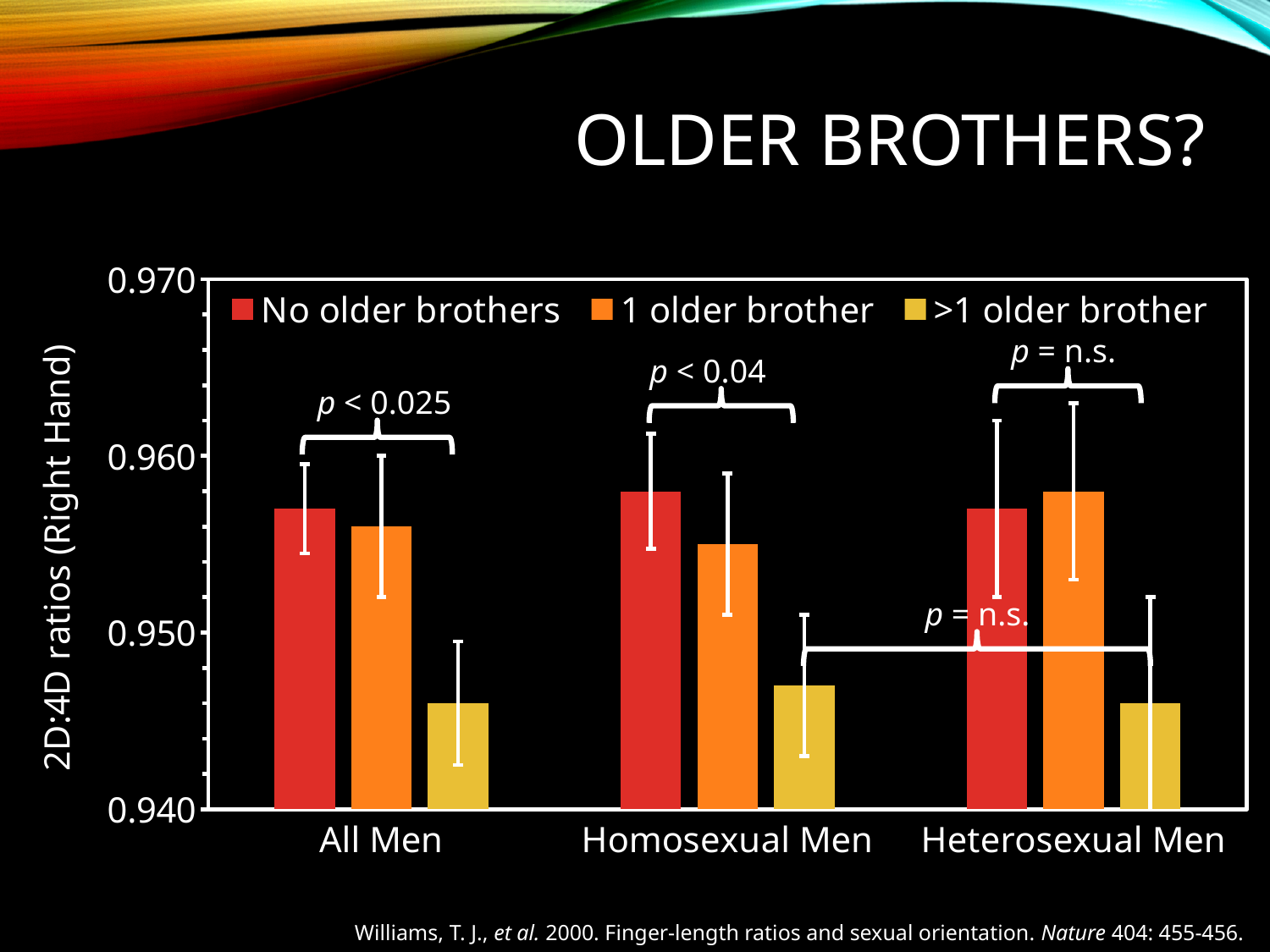
What is the label of the y axis? 2D:4D ratios (Right Hand) Is the value for 1 older brother in the Homosexual Men group greater or less than 0.950? greater How many categories are shown on the x axis? 3 Within the All Men group, which series has the lowest value? >1 older brother Is the value for >1 older brother in the Heterosexual Men group greater or less than 0.950? less Is the value for >1 older brother in the All Men group greater or less than 0.950? less In the All Men group, which is larger: No older brothers or >1 older brother? No older brothers Within the Homosexual Men group, which series has the highest value? No older brothers What p-value annotation is shown above the All Men group? p < 0.025 What kind of chart is shown on the slide? Bar chart How many series does the legend list? 3